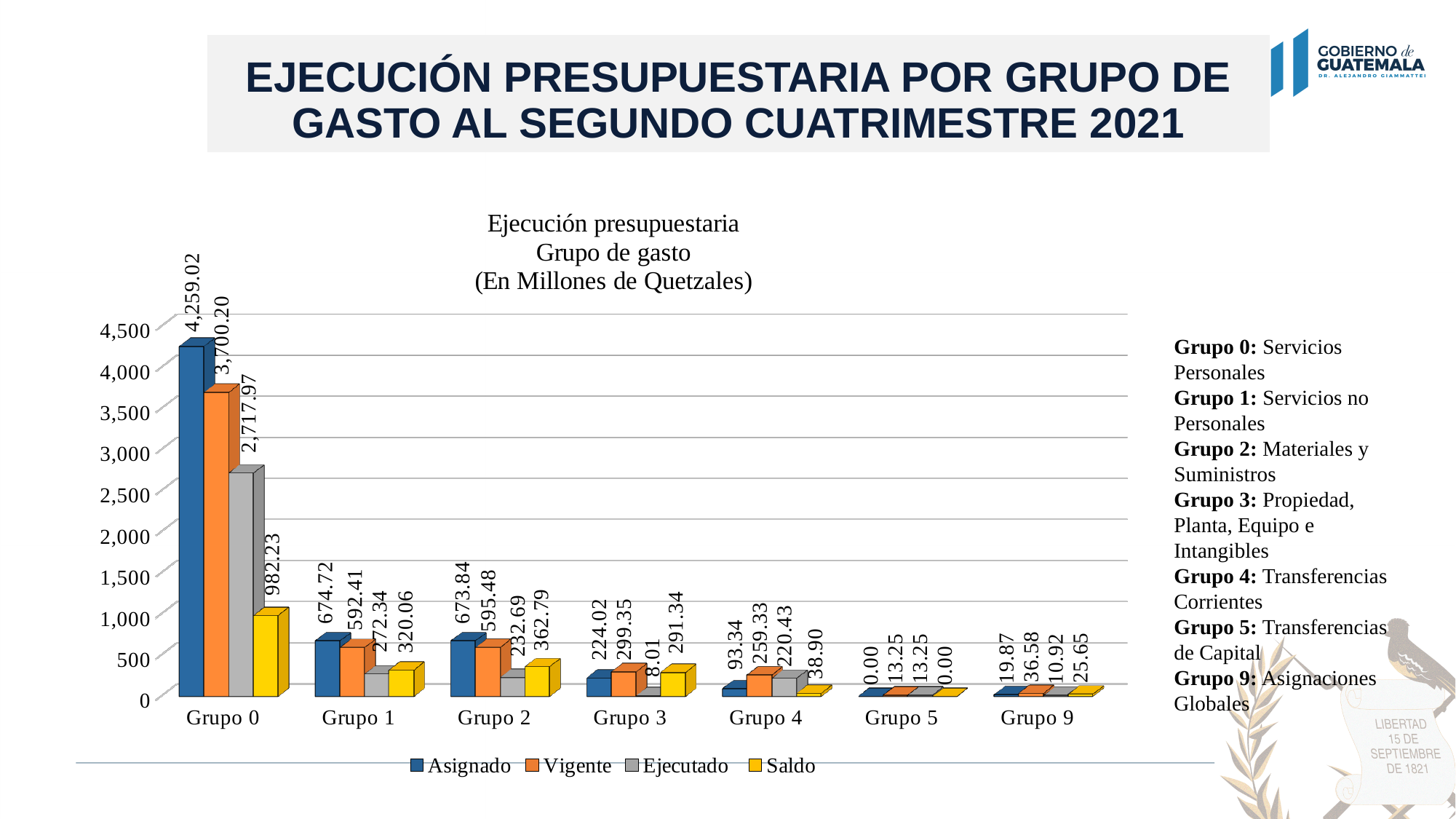
What is the difference between the Vigente and Ejecutado values for Grupo 4? 38.90 How many series does the chart legend list? 4 What is the difference between the Vigente and Ejecutado values for Grupo 0? 982.23 Which group has the highest Vigente value? Grupo 0 What is the Saldo value for Grupo 2? 362.79 What is the Ejecutado value for Grupo 3? 8.01 Which group has the lowest Asignado value? Grupo 5 Which has a larger Vigente value, Grupo 3 or Grupo 4? Grupo 3 How many groups (categories) are shown on the x axis of the chart? 7 What is the Asignado value for Grupo 0? 4,259.02 What kind of chart is shown on the slide? Bar chart Is the Ejecutado value for Grupo 0 greater or less than 3,000? less